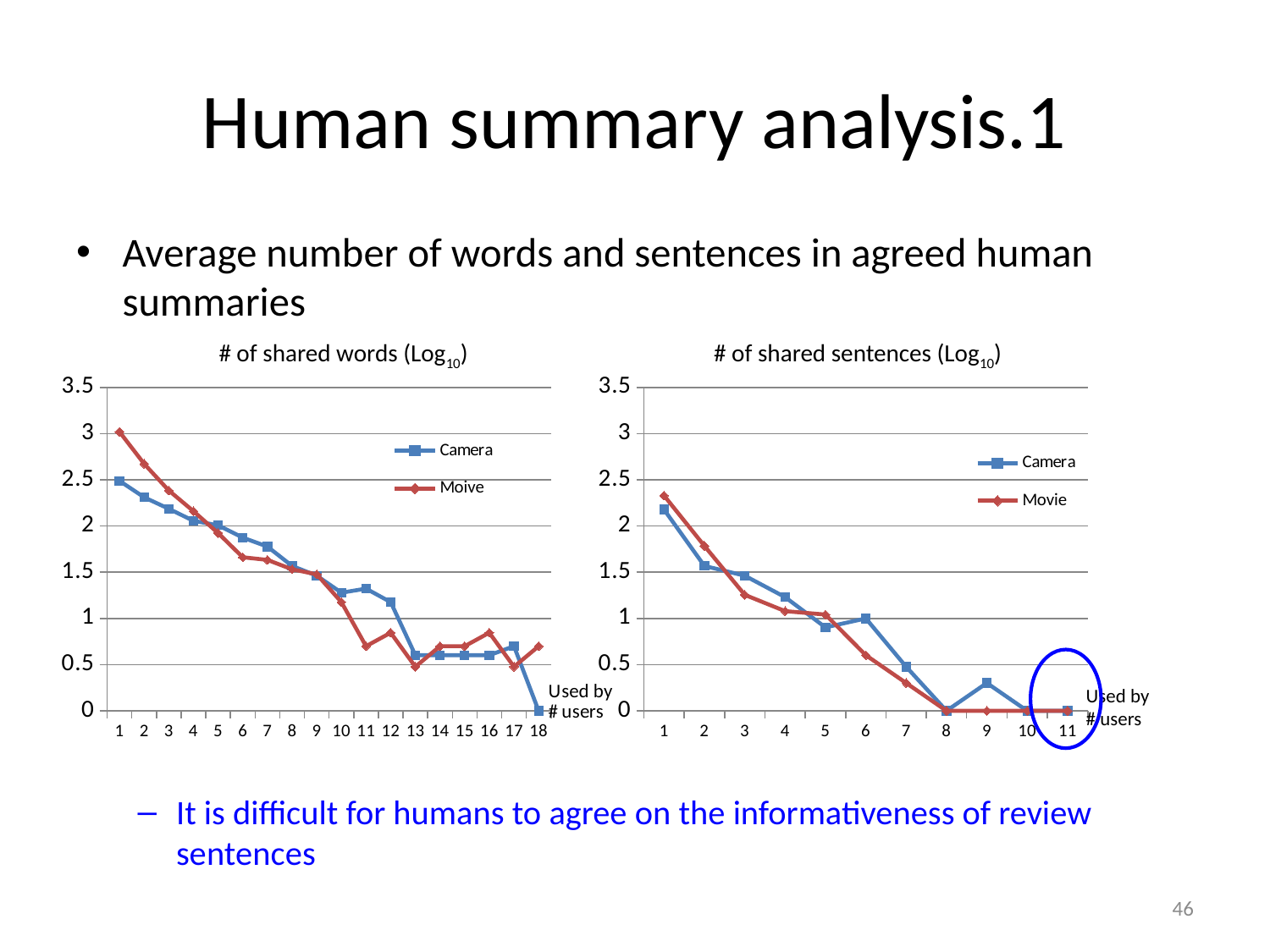
How many x-axis categories (users) does the '# of shared words (Log10)' chart show? 18 What kind of chart is the '# of shared words (Log10)' chart? line chart In the '# of shared sentences (Log10)' chart, is the Camera value at 9 users greater or less than 0.5? less In the '# of shared words (Log10)' chart, which series has the higher value at 1 user, Camera or Moive? Moive What are the two legend entries in the '# of shared words (Log10)' chart? Camera and Moive In the '# of shared sentences (Log10)' chart, what is the Camera value at 11 users? 0 In the '# of shared words (Log10)' chart, what is the Camera value at 18 users? 0 In the '# of shared sentences (Log10)' chart, what is the Movie value at 8 users? 0 How many x-axis categories (users) does the '# of shared sentences (Log10)' chart show? 11 In the '# of shared words (Log10)' chart, do the values generally rise or fall as the number of users increases? fall How many series does the legend of the '# of shared sentences (Log10)' chart list? 2